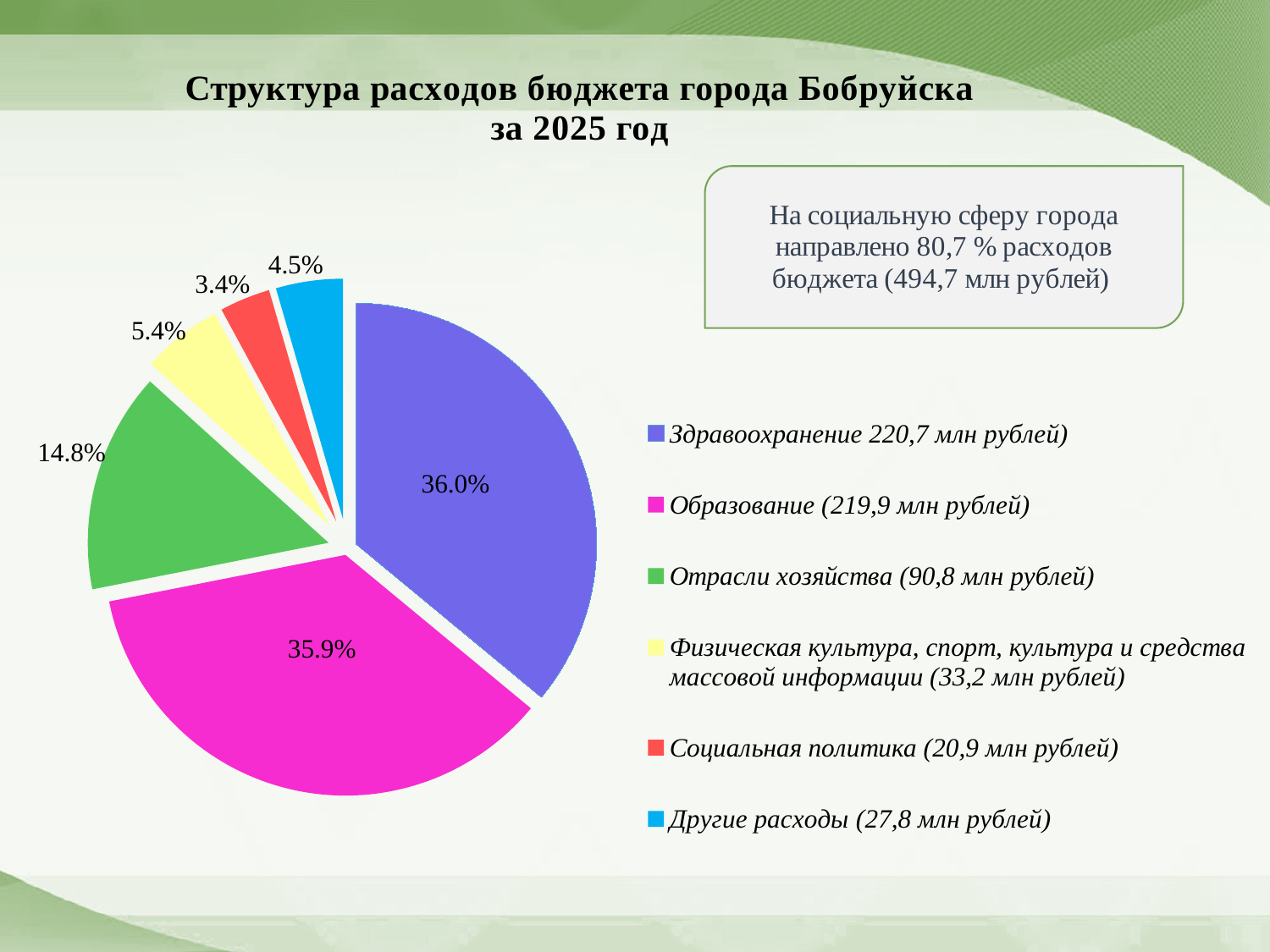
What share of the budget expenditure goes to Социальная политика? 3.4% Which is larger: the share for Отрасли хозяйства or the share for Другие расходы? Отрасли хозяйства What share of the budget expenditure goes to Образование? 35.9% What is the title of the chart? Структура расходов бюджета города Бобруйска за 2025 год What type of chart is shown on the slide? pie chart What share of the budget expenditure goes to Другие расходы? 4.5% How many slices does the pie chart have? 6 According to the legend, how many million rubles are allocated to Образование? 219,9 млн рублей What share of the budget expenditure goes to Отрасли хозяйства? 14.8% What share of the budget expenditure goes to Здравоохранение? 36.0% What is the difference in percentage points between the share for Отрасли хозяйства and the share for Физическая культура, спорт, культура и средства массовой информации? 9.4 Which category has the smallest share of the pie? Социальная политика